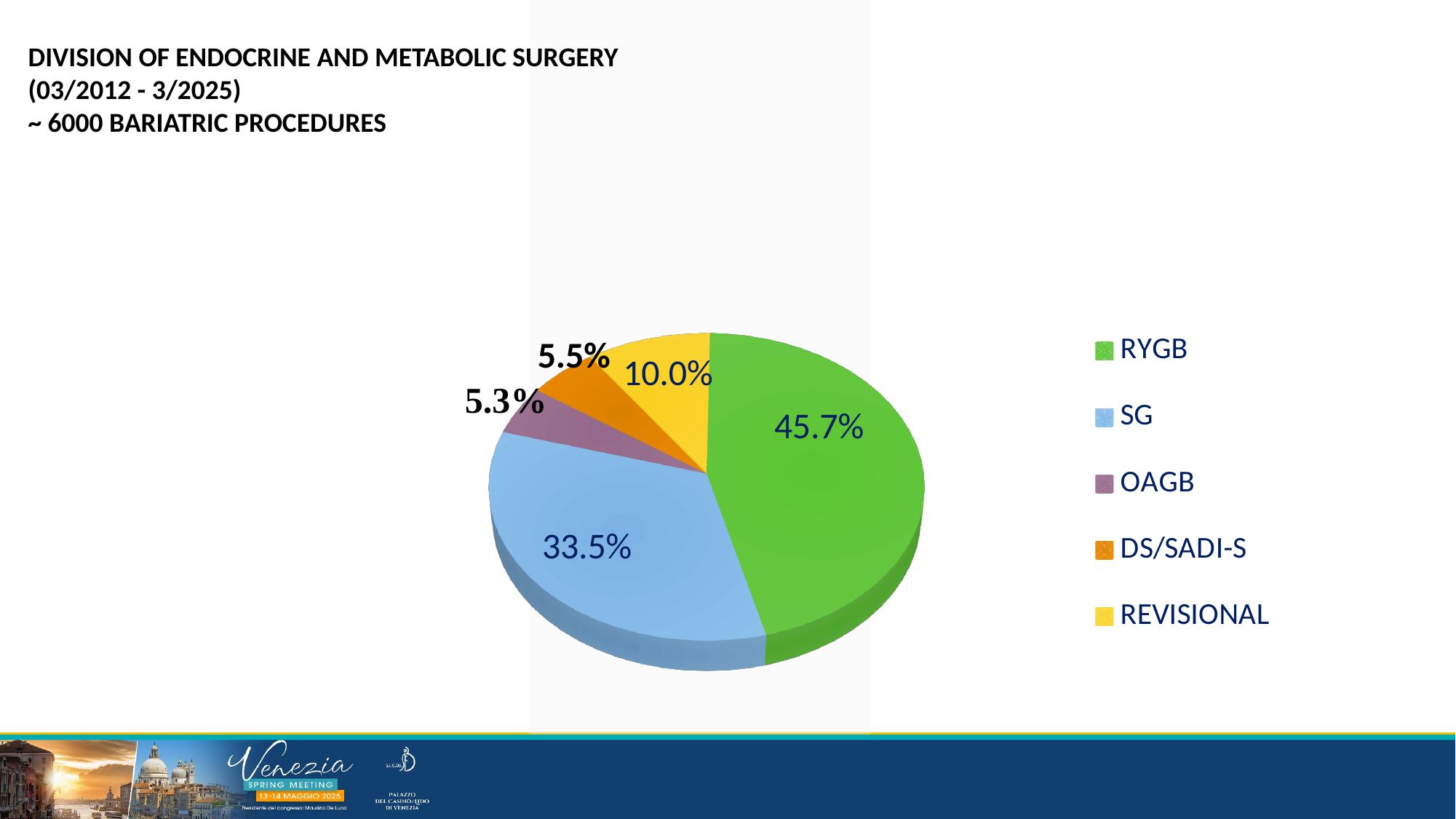
What percentage of procedures does the RYGB slice represent? 45.7% What percentage is shown for the DS/SADI-S slice? 5.5% What percentage is shown for the OAGB slice? 5.3% What type of chart is shown on the slide? Pie chart Which procedure has the largest share of the pie? RYGB What percentage is shown for the REVISIONAL slice? 10.0% What percentage is shown for the SG slice? 33.5% Which procedure has the smallest share of the pie? OAGB Which slice is larger, SG or REVISIONAL? SG How many slices does the pie chart have? 5 What is the difference in percentage points between the RYGB and SG slices? 12.2 What colour is the SG slice in the pie chart? Light blue